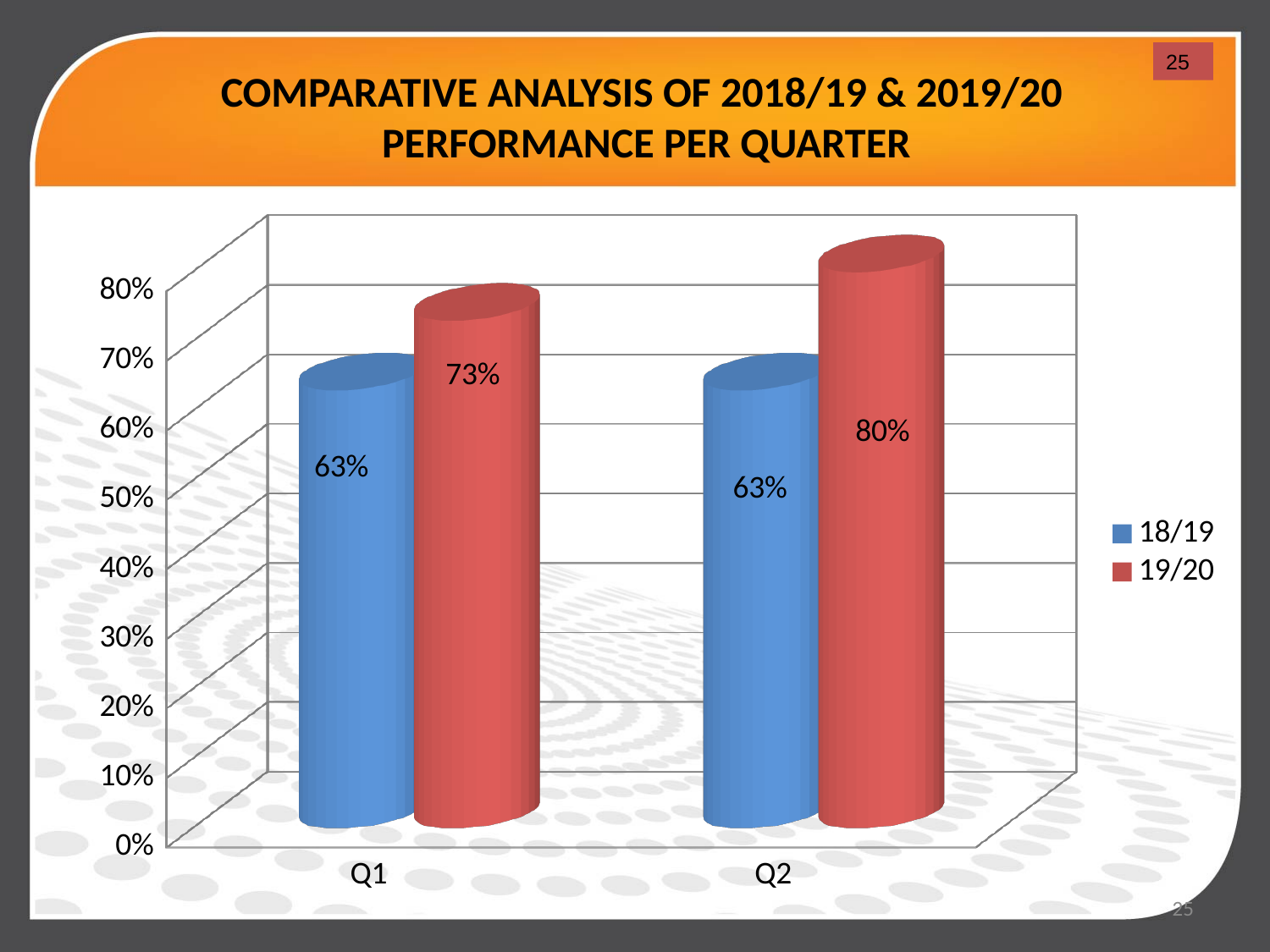
What kind of chart is shown on the slide? Bar chart Which quarter has the highest value for the 19/20 series? Q2 How many series does the legend list? 2 What is the difference between the 19/20 and 18/19 values in Q1? 10% What is the value for 18/19 in Q2? 63% What is the value for 19/20 in Q1? 73% Which is larger in Q1, the 18/19 value or the 19/20 value? 19/20 What is the value for 19/20 in Q2? 80% What is the difference between the 19/20 and 18/19 values in Q2? 17% Which colour represents the 19/20 series? Red What is the value for 18/19 in Q1? 63% How many quarters are shown on the x axis? 2